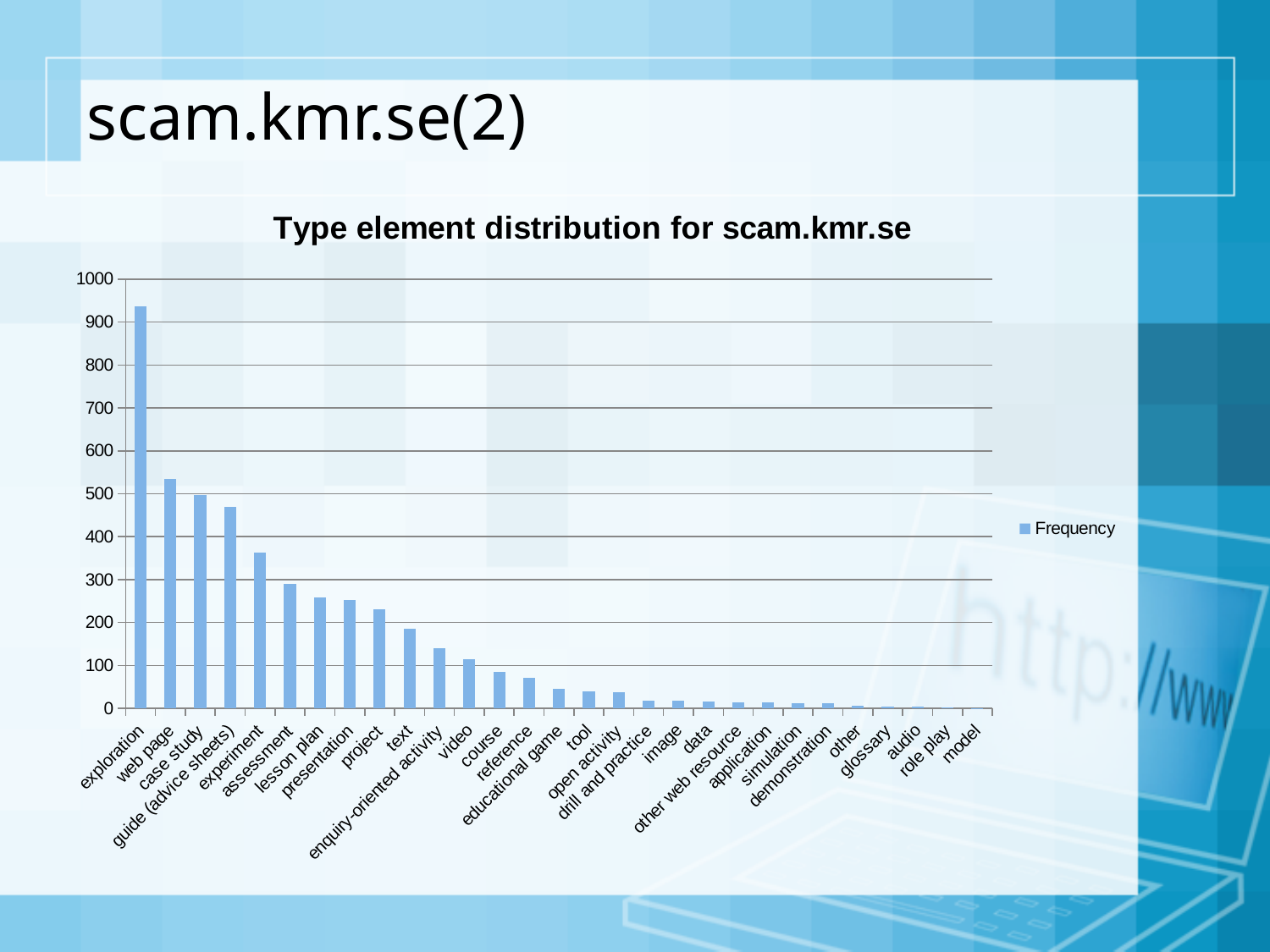
What is the name of the series shown in the legend? Frequency Is the value for experiment greater or less than 300? greater Do the values rise or fall moving from left to right along the x axis? fall What is the title of the chart? Type element distribution for scam.kmr.se Is the value for exploration greater or less than 900? greater Is the value for text greater or less than 200? less Which category has the highest frequency? exploration What kind of chart is shown on the slide? bar chart How many categories are shown on the x axis? 29 Which is larger, the value for case study or the value for lesson plan? case study How many series does the legend list? 1